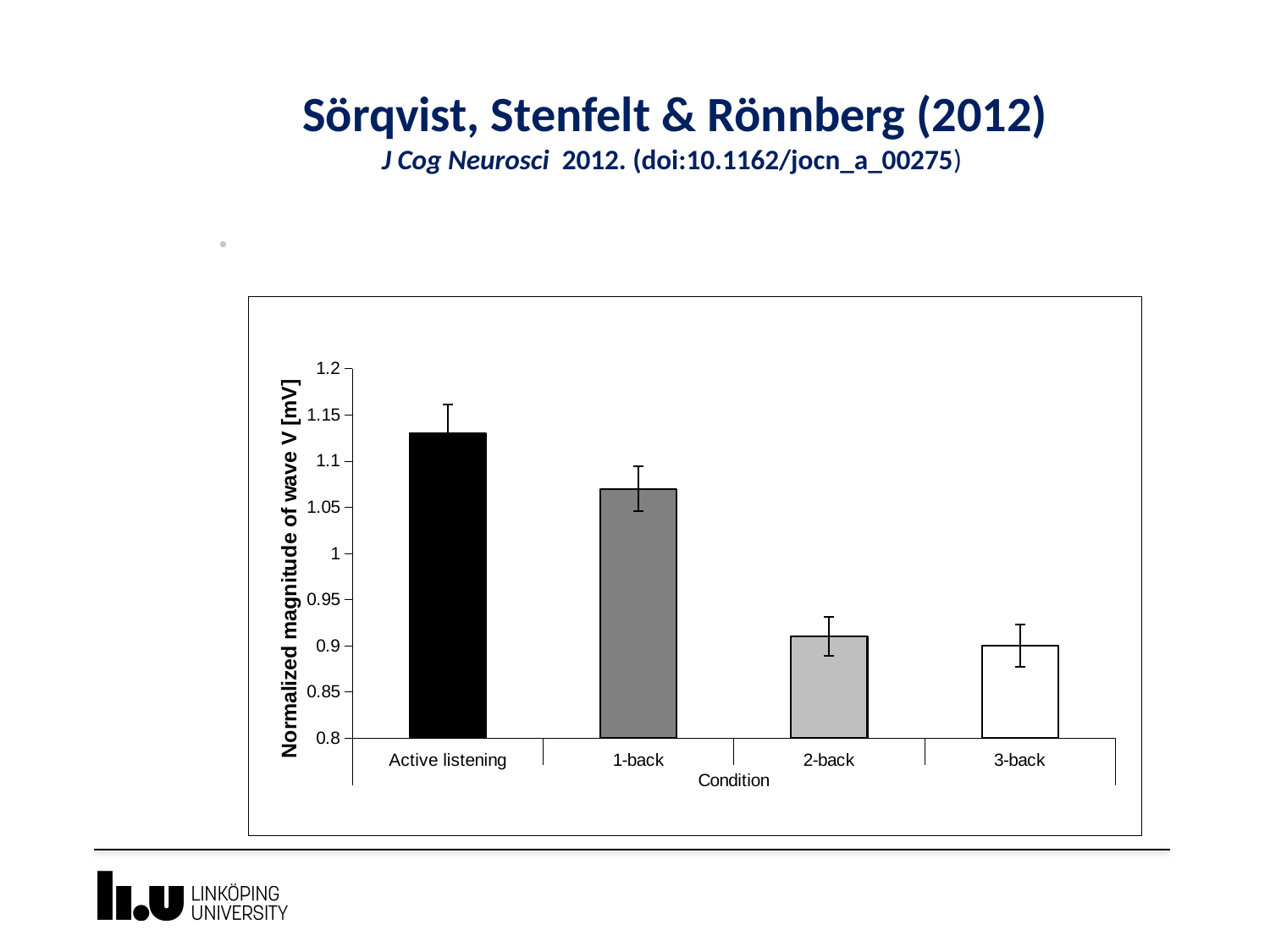
Which is larger, the value for 1-back or the value for 2-back? 1-back Which is larger, the value for Active listening or the value for 1-back? Active listening Is the value for 1-back greater or less than 1.05? greater Which condition has the highest normalized magnitude of wave V? Active listening What is the label of the y axis of the chart? Normalized magnitude of wave V [mV] Is the value for 3-back greater or less than 0.95? less What kind of chart is shown on the slide? bar chart Is the value for 2-back greater or less than 1? less Do the values rise or fall from Active listening to 3-back along the x axis? fall How many conditions are shown on the x axis of the chart? 4